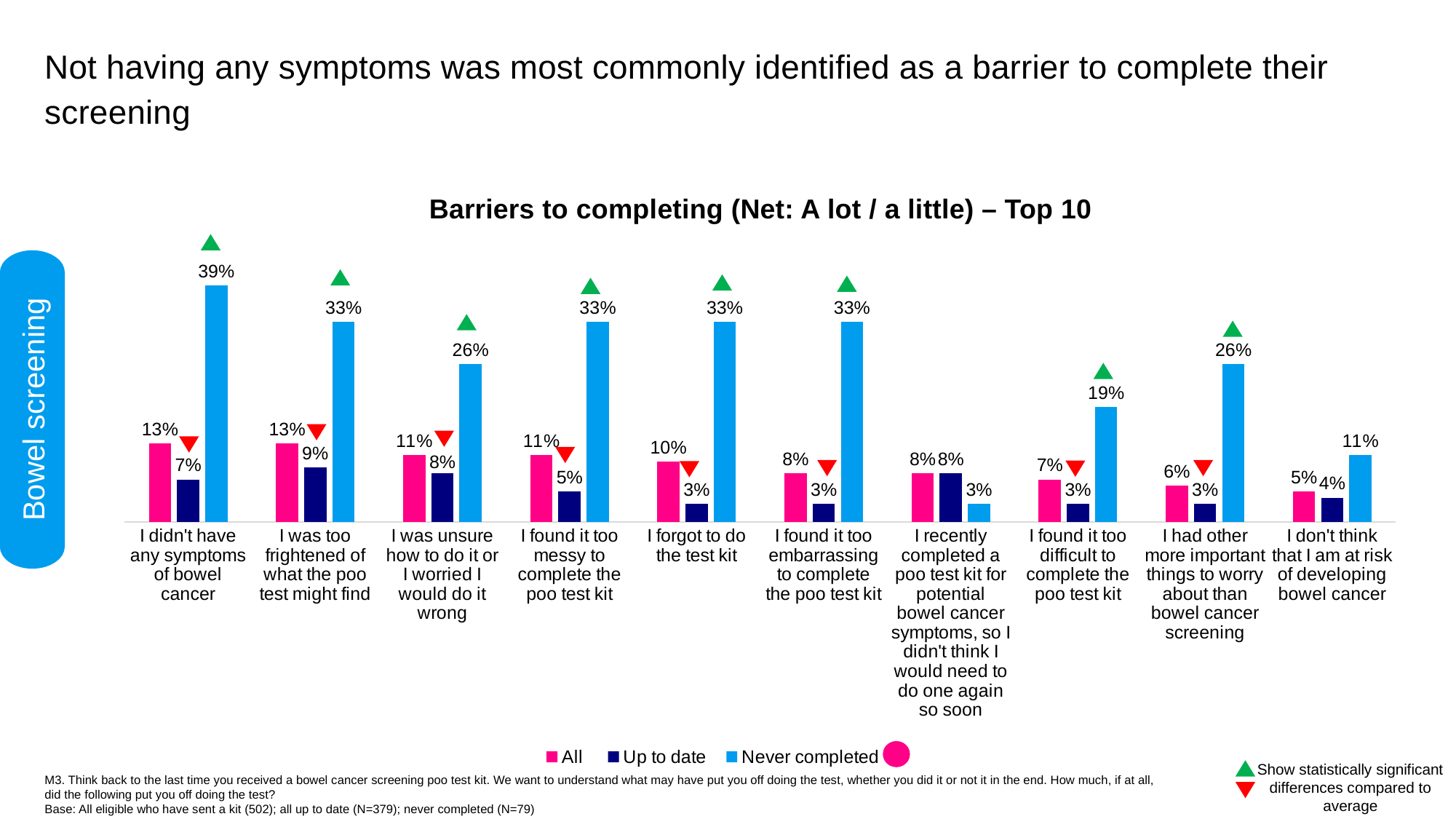
What kind of chart is shown on the slide? Bar chart What is the 'Never completed' value for 'I recently completed a poo test kit for potential bowel cancer symptoms, so I didn't think I would need to do one again so soon'? 3% Which is larger for 'I found it too difficult to complete the poo test kit': the 'All' value or the 'Never completed' value? Never completed What is the difference between the 'Never completed' and 'Up to date' values for 'I didn't have any symptoms of bowel cancer'? 32% How many series does the legend list? 3 How many barrier categories are shown on the x axis? 10 What is the title of the chart? Barriers to completing (Net: A lot / a little) – Top 10 Which category has the highest 'Never completed' value? I didn't have any symptoms of bowel cancer What is the 'Up to date' value for 'I was too frightened of what the poo test might find'? 9% What is the 'All' value for 'I forgot to do the test kit'? 10% What is the 'Never completed' value for 'I didn't have any symptoms of bowel cancer'? 39% Which category has the lowest 'All' value? I don't think that I am at risk of developing bowel cancer